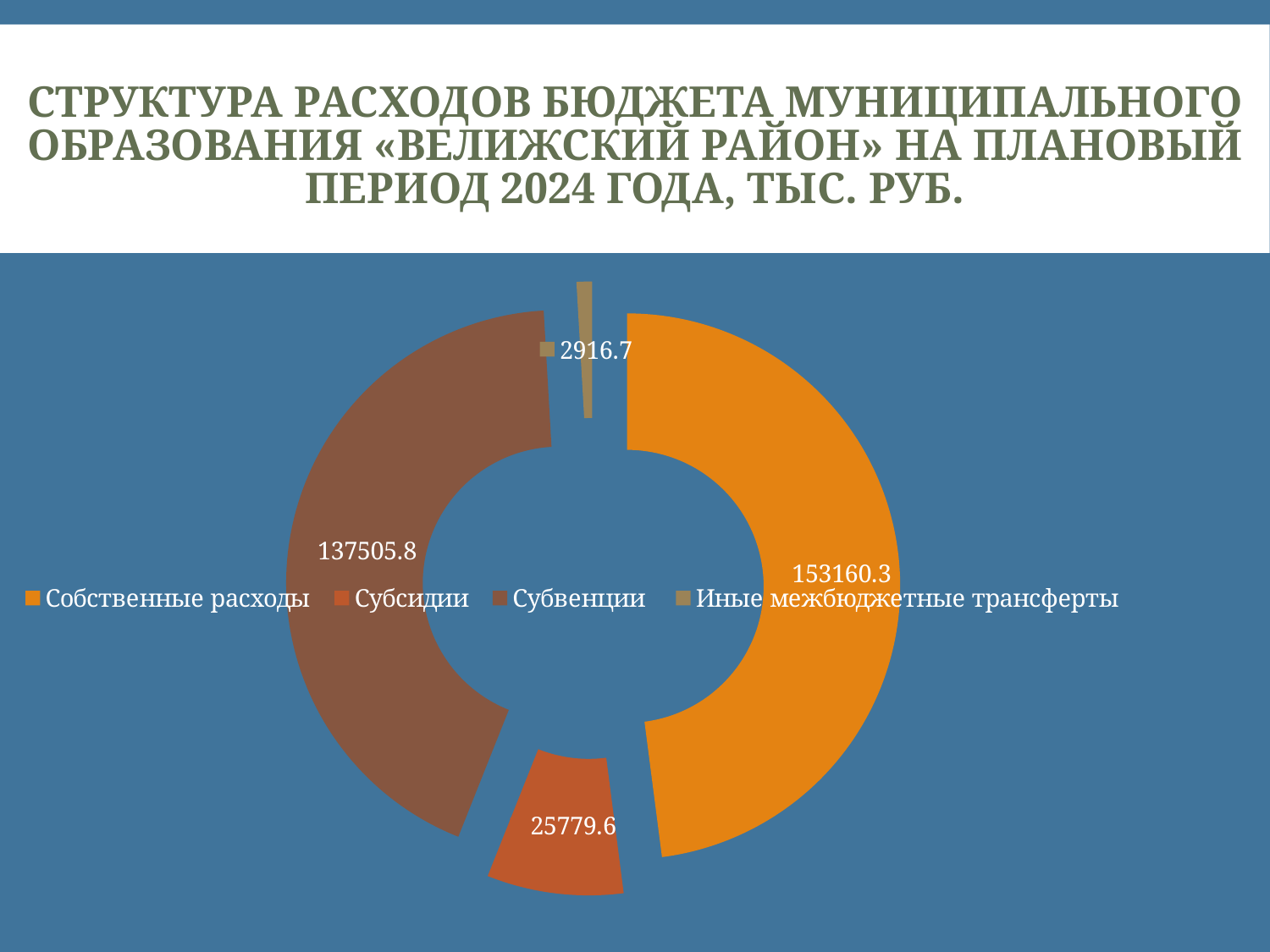
Which category has the smallest value? Иные межбюджетные трансферты Which category has the largest value? Собственные расходы What is the value for Субсидии? 25779.6 What is the value for Субвенции? 137505.8 How many categories does the chart show? 4 What is the value for Собственные расходы? 153160.3 What is the difference between Собственные расходы and Субвенции? 15654.5 What is the value for Иные межбюджетные трансферты? 2916.7 What is the total of all four categories shown in the chart? 319362.4 What kind of chart is shown on the slide? doughnut chart What is the difference between Субсидии and Иные межбюджетные трансферты? 22862.9 Which is larger, Субсидии or Субвенции? Субвенции